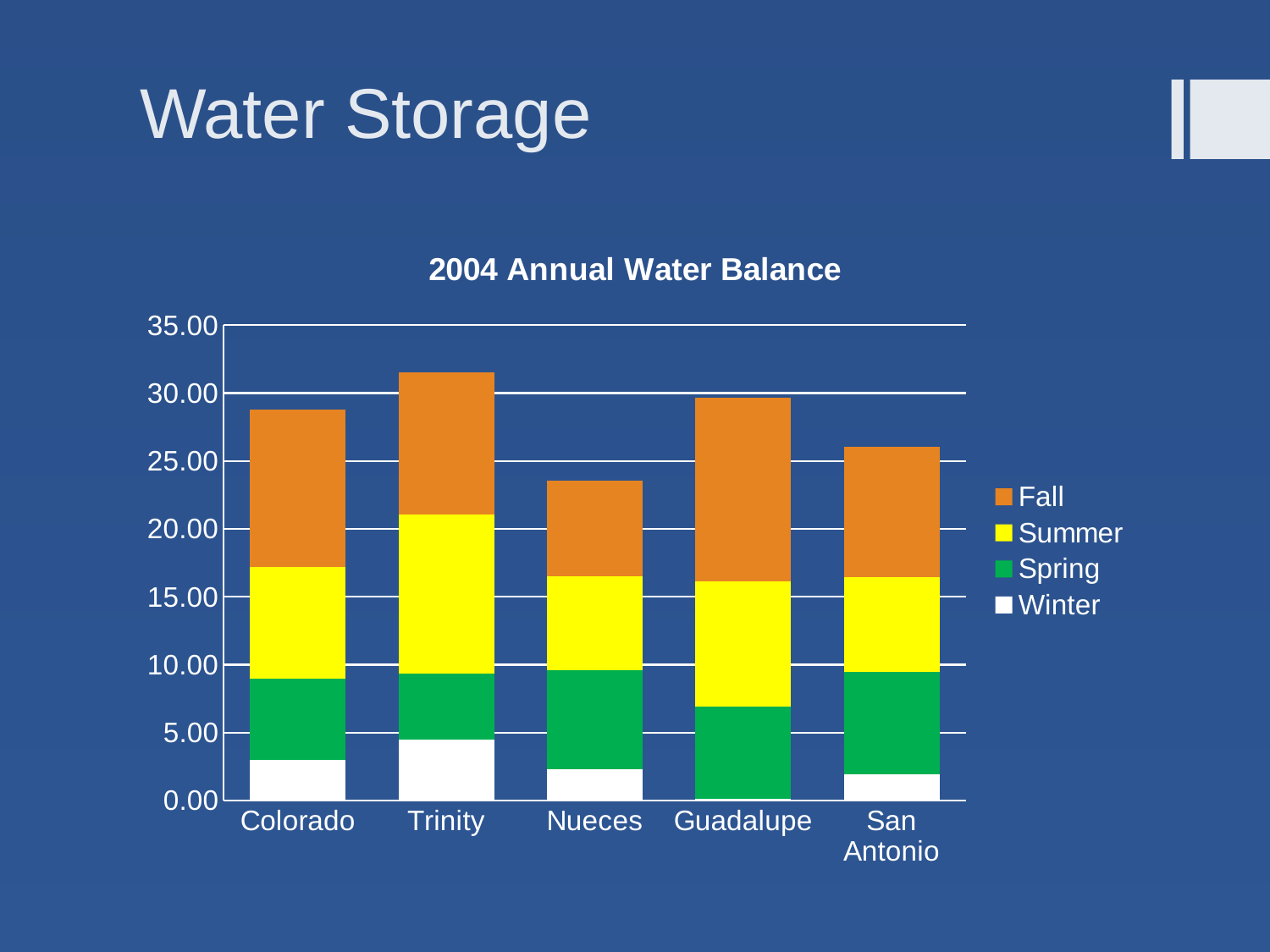
Which has the larger total stacked bar, Colorado or San Antonio? Colorado What kind of chart is shown on the slide? Stacked bar chart Is the total stacked value for Colorado greater or less than 30.00? less What is the title of the chart? 2004 Annual Water Balance Which category has the tallest stacked bar overall? Trinity How many river basins (categories) are shown on the x axis? 5 Is the total stacked value for Trinity greater or less than 30.00? greater Is the total stacked value for Nueces greater or less than 25.00? less How many series does the legend list? 4 Which series is shown in orange in the legend? Fall Which category has the shortest stacked bar overall? Nueces